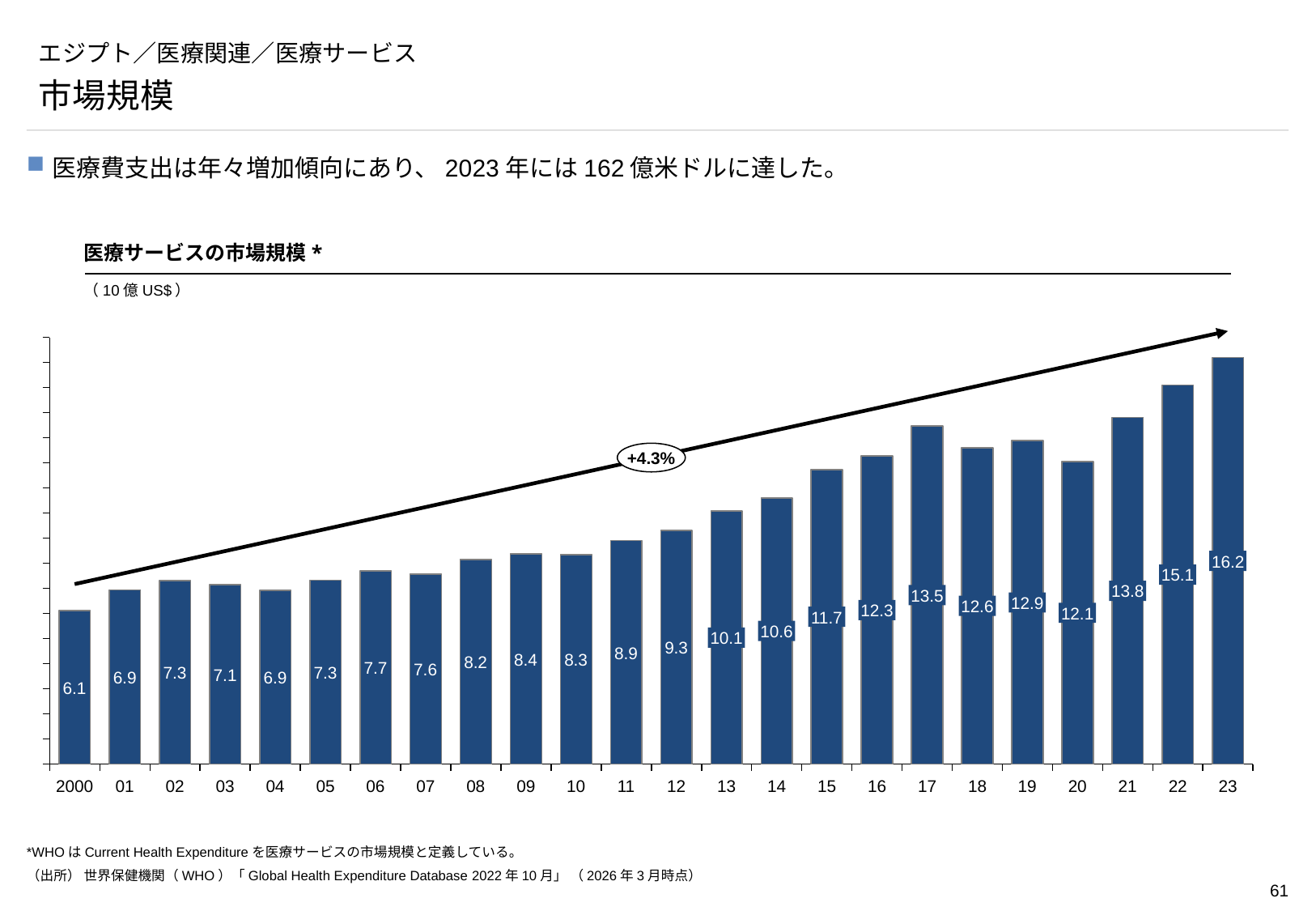
What kind of chart is shown on the slide? Bar chart What is the value for 2017 in the chart? 13.5 What is the value for 2023 in the chart? 16.2 What growth rate is annotated on the arrow above the bars? +4.3% What is the difference between the values for 2017 and 2018? 0.9 Which year has the lowest value in the chart? 2000 Which year has the highest value in the chart? 23 What is the value for 2013 in the chart? 10.1 Which is larger, the value for 2017 or the value for 2018? 2017 How many years (bars) are shown in the chart? 24 What is the difference between the values for 2023 and 2000? 10.1 What is the value for 2000 in the chart? 6.1